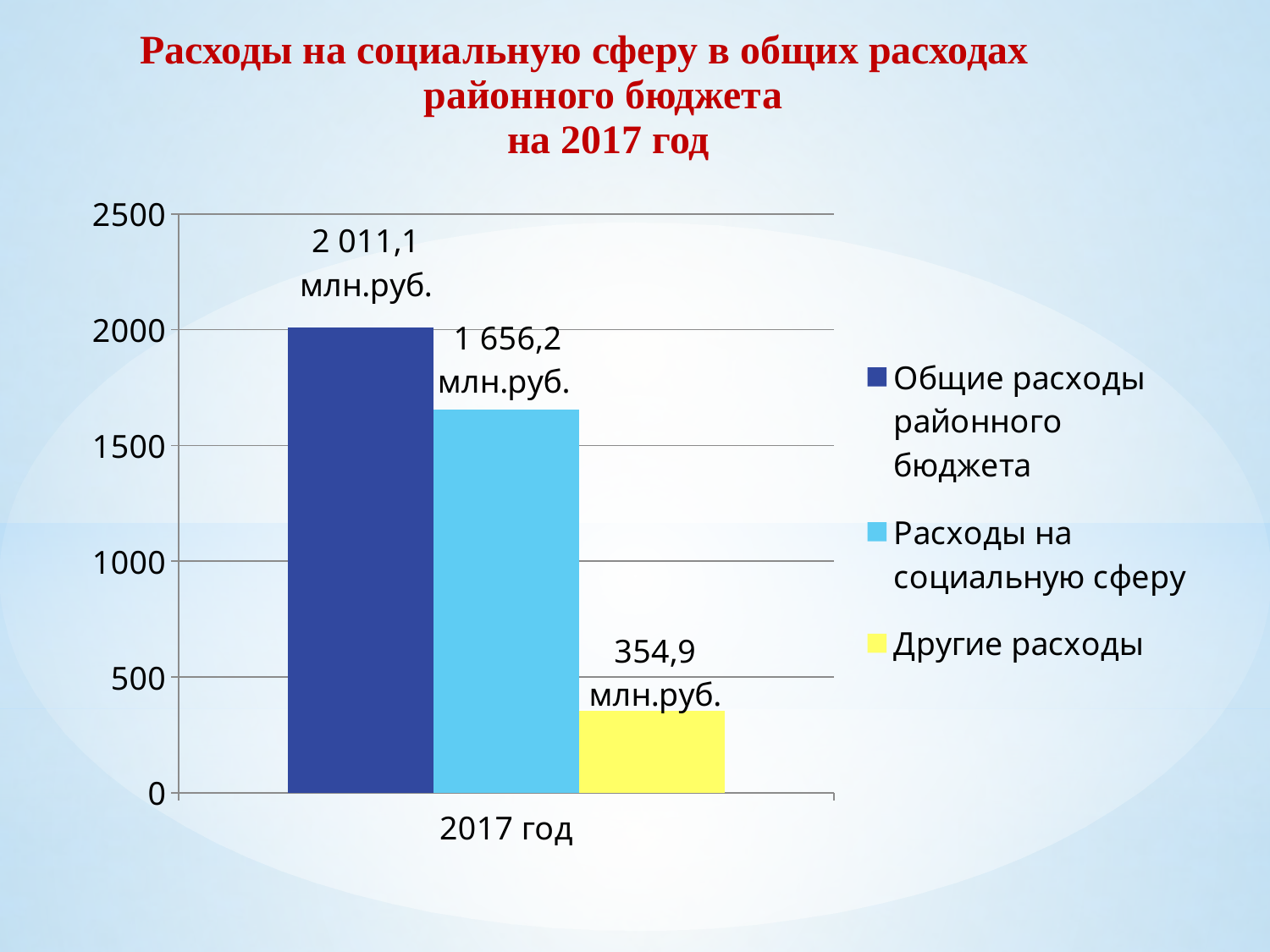
What is the difference between Расходы на социальную сферу and Другие расходы? 1 301,3 млн.руб. How many series does the legend list? 3 What is the value for Общие расходы районного бюджета in 2017 год? 2 011,1 млн.руб. What is the value for Другие расходы in 2017 год? 354,9 млн.руб. Which series has the lowest value on the chart? Другие расходы Is the value for Другие расходы greater or less than 500? less Which series has the highest value on the chart? Общие расходы районного бюджета What is the difference between Общие расходы районного бюджета and Расходы на социальную сферу? 354,9 млн.руб. Which is larger, Расходы на социальную сферу or Другие расходы? Расходы на социальную сферу What colour is the bar for Другие расходы? yellow What kind of chart is shown on the slide? bar chart What is the value for Расходы на социальную сферу in 2017 год? 1 656,2 млн.руб.